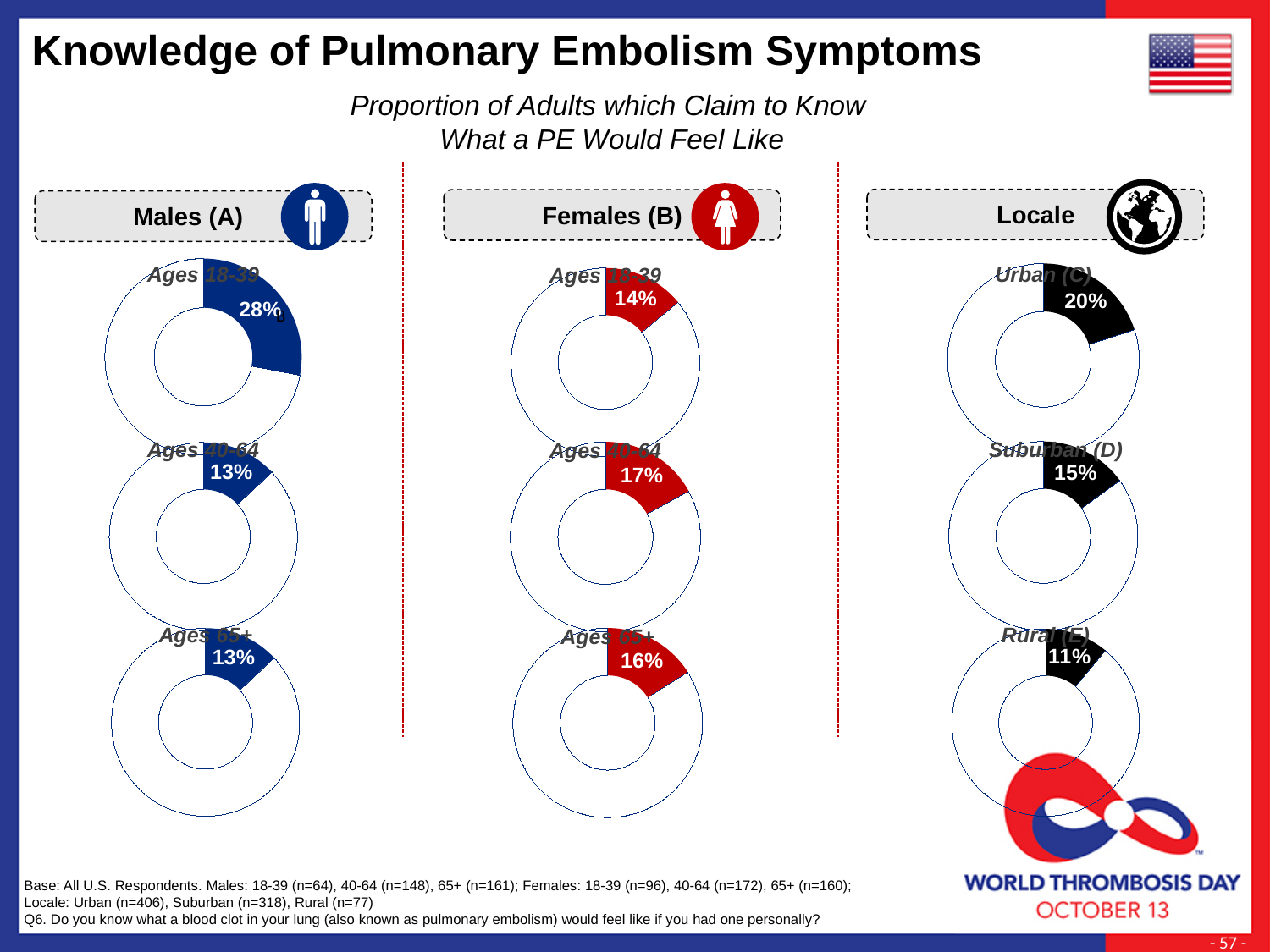
Which is larger: the Females (B) ages 65+ value or the Males (A) ages 65+ value? Females (B) ages 65+ How many donut charts are shown on the slide in total? 9 In the Locale column, what percentage is shown for Rural (E)? 11% In the Females (B) column, what is the value shown for ages 40-64? 17% In the Males (A) column, what percentage of adults aged 18-39 claim to know what a PE would feel like? 28% In the Males (A) column, which age group has the highest percentage? Ages 18-39 What is the difference between the Urban (C) and Suburban (D) values in the Locale column? 5 percentage points In the Locale column, what percentage is shown for Urban (C)? 20% In the Locale column, which locale has the lowest percentage? Rural (E) What type of chart is used to show the Males (A) ages 18-39 value? Donut (pie) chart In the Females (B) column, which age group has the lowest percentage? Ages 18-39 What is the difference between the Males (A) ages 18-39 value and the Females (B) ages 18-39 value? 14 percentage points